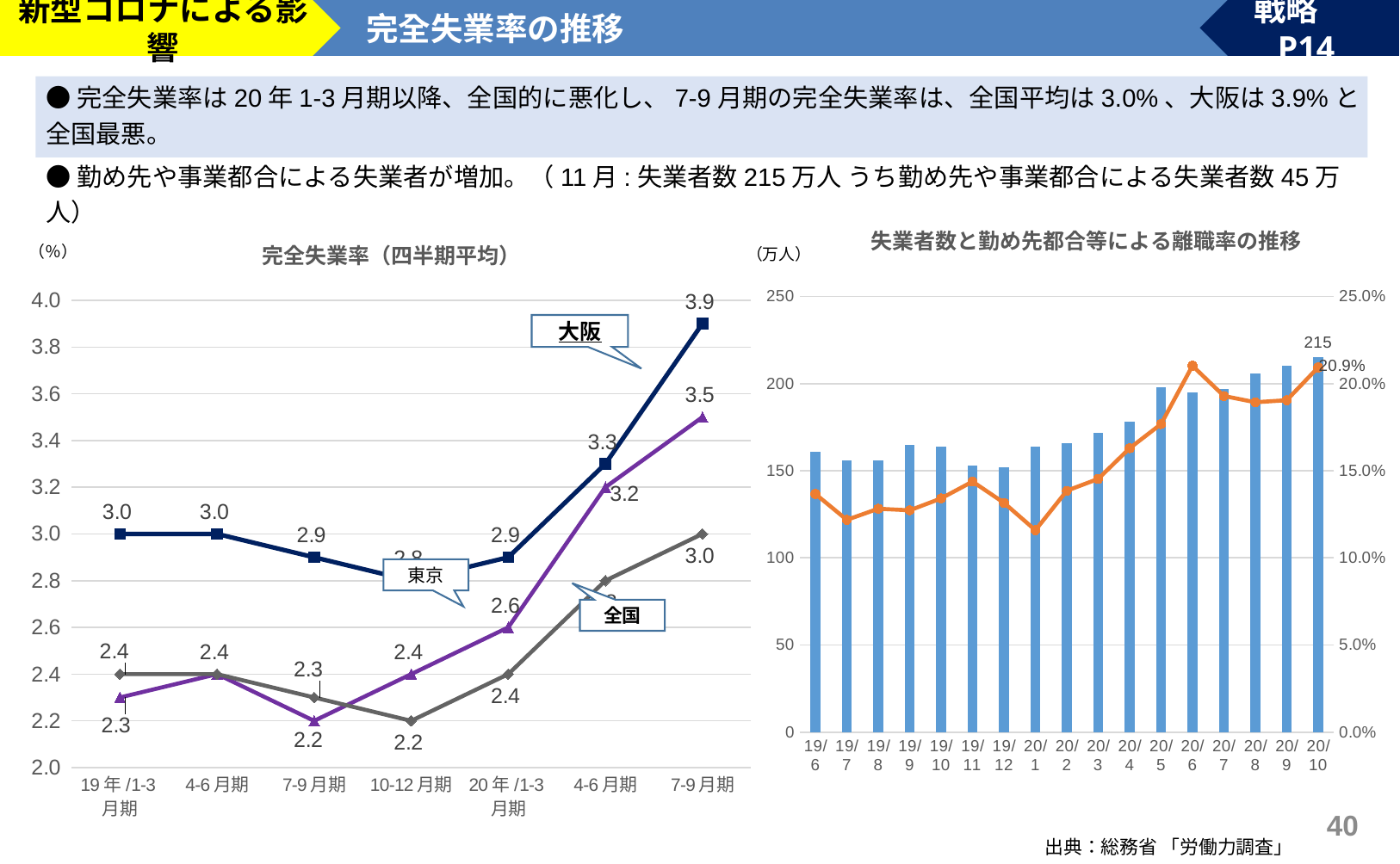
In the right chart 失業者数と勤め先都合等による離職率の推移, is the bar for 20/1 greater or less than 200? less In the right chart 失業者数と勤め先都合等による離職率の推移, what is the rate shown for 20/10? 20.9% How many quarterly periods are shown on the x axis of the left chart 完全失業率（四半期平均）? 7 In the left chart 完全失業率（四半期平均）, what is the value for 東京 in 19年7-9月期? 2.2 What kind of chart is the left chart 完全失業率（四半期平均）? line chart In the left chart 完全失業率（四半期平均）, what is the value for 東京 in 20年7-9月期? 3.5 In the left chart 完全失業率（四半期平均）, what is the difference between 大阪 and 全国 in 20年7-9月期? 0.9 In the left chart 完全失業率（四半期平均）, what is the value for 全国 in 20年7-9月期? 3.0 In the left chart 完全失業率（四半期平均）, in which period is 東京 at its lowest? 7-9月期 (2019) In the left chart 完全失業率（四半期平均）, what is the value for 大阪 in 20年7-9月期? 3.9 In the left chart 完全失業率（四半期平均）, which is higher in 20年4-6月期, 大阪 or 東京? 大阪 In the right chart 失業者数と勤め先都合等による離職率の推移, what is the value of the bar for 20/10? 215